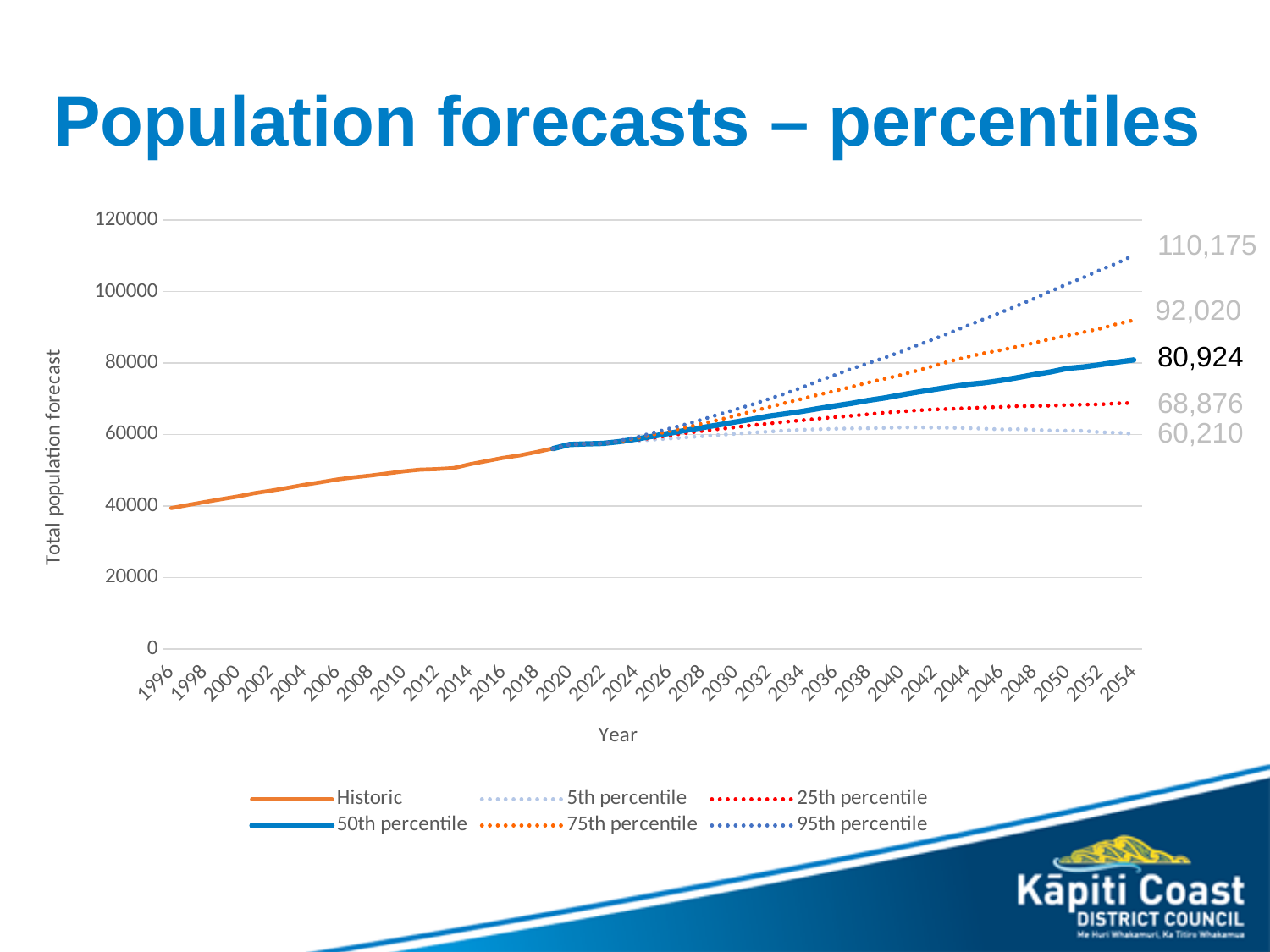
What is the 75th percentile population forecast value labelled at the end of the chart (2054)? 92,020 How many series does the legend list? 6 Which series has the highest value at 2054? 95th percentile What is the difference between the 75th percentile and 25th percentile values at 2054? 23,144 What is the 5th percentile population forecast value labelled at the end of the chart (2054)? 60,210 Does the 50th percentile series rise or fall from 2020 to 2054? Rise What is the 50th percentile population forecast value labelled at the end of the chart (2054)? 80,924 Which series has the lowest value at 2054? 5th percentile What is the difference between the 95th percentile and 5th percentile values at 2054? 49,965 What kind of chart is shown on the slide? Line chart What is the 95th percentile population forecast value labelled at the end of the chart (2054)? 110,175 Is the Historic value for 1996 greater or less than 60000? less